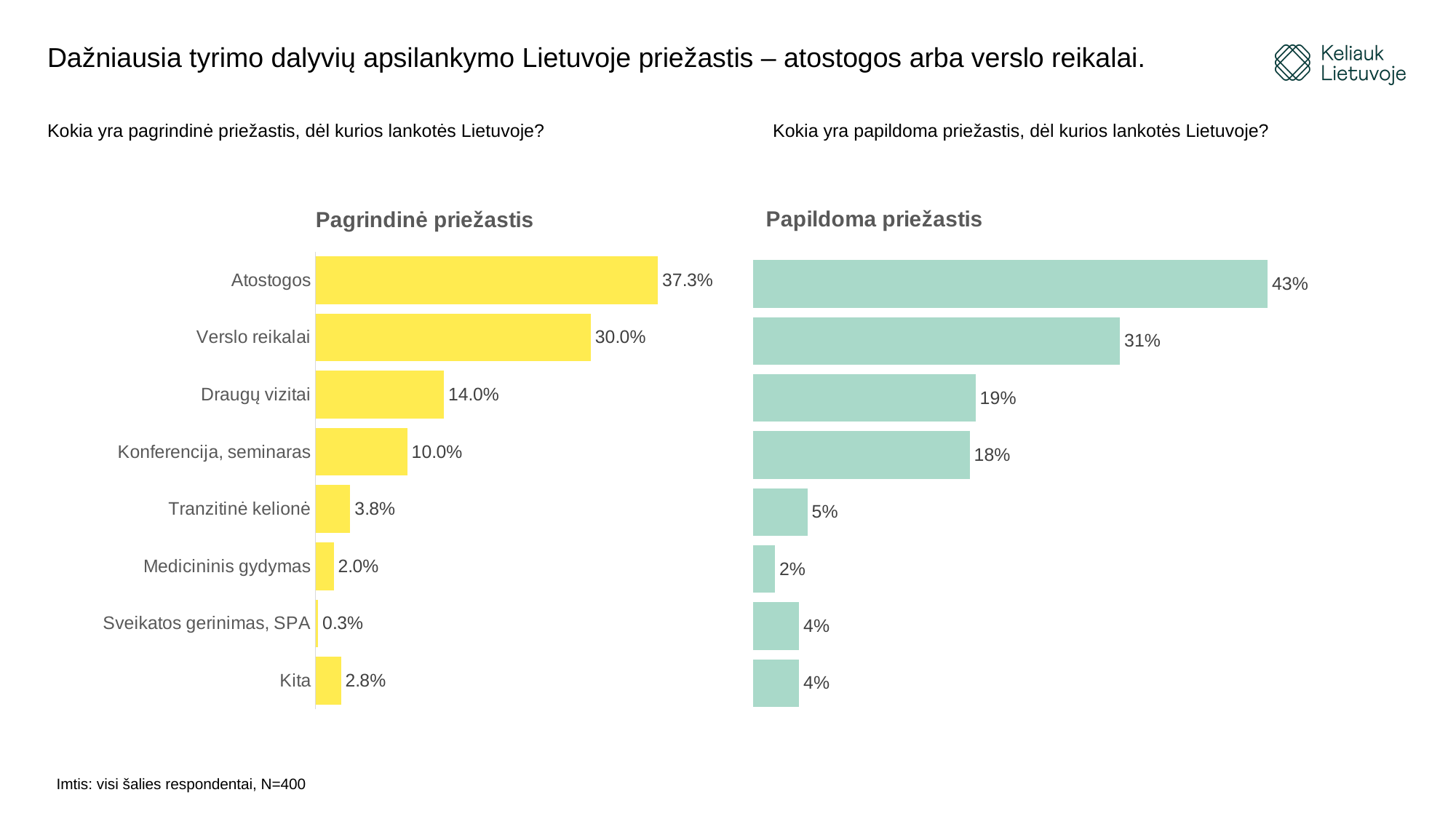
In the 'Pagrindinė priežastis' chart, which is larger: Tranzitinė kelionė or Kita? Tranzitinė kelionė In the 'Pagrindinė priežastis' chart, which category has the lowest value? Sveikatos gerinimas, SPA In the 'Pagrindinė priežastis' chart, what is the difference between Atostogos and Verslo reikalai? 7.3% In the 'Papildoma priežastis' chart, what is the difference between Atostogos and Konferencija, seminaras? 25% What kind of chart is the 'Papildoma priežastis' chart? Bar chart What is the sample size stated at the bottom of the slide? N=400 In the 'Pagrindinė priežastis' chart, which category has the highest value? Atostogos How many categories does the 'Pagrindinė priežastis' chart show? 8 In the 'Papildoma priežastis' chart, what is the value for Draugų vizitai? 19% In the 'Pagrindinė priežastis' chart, what is the value for Verslo reikalai? 30.0% Which is larger: Konferencija, seminaras in the 'Pagrindinė priežastis' chart or Konferencija, seminaras in the 'Papildoma priežastis' chart? Papildoma priežastis In the 'Papildoma priežastis' chart, which category has the lowest value? Medicininis gydymas